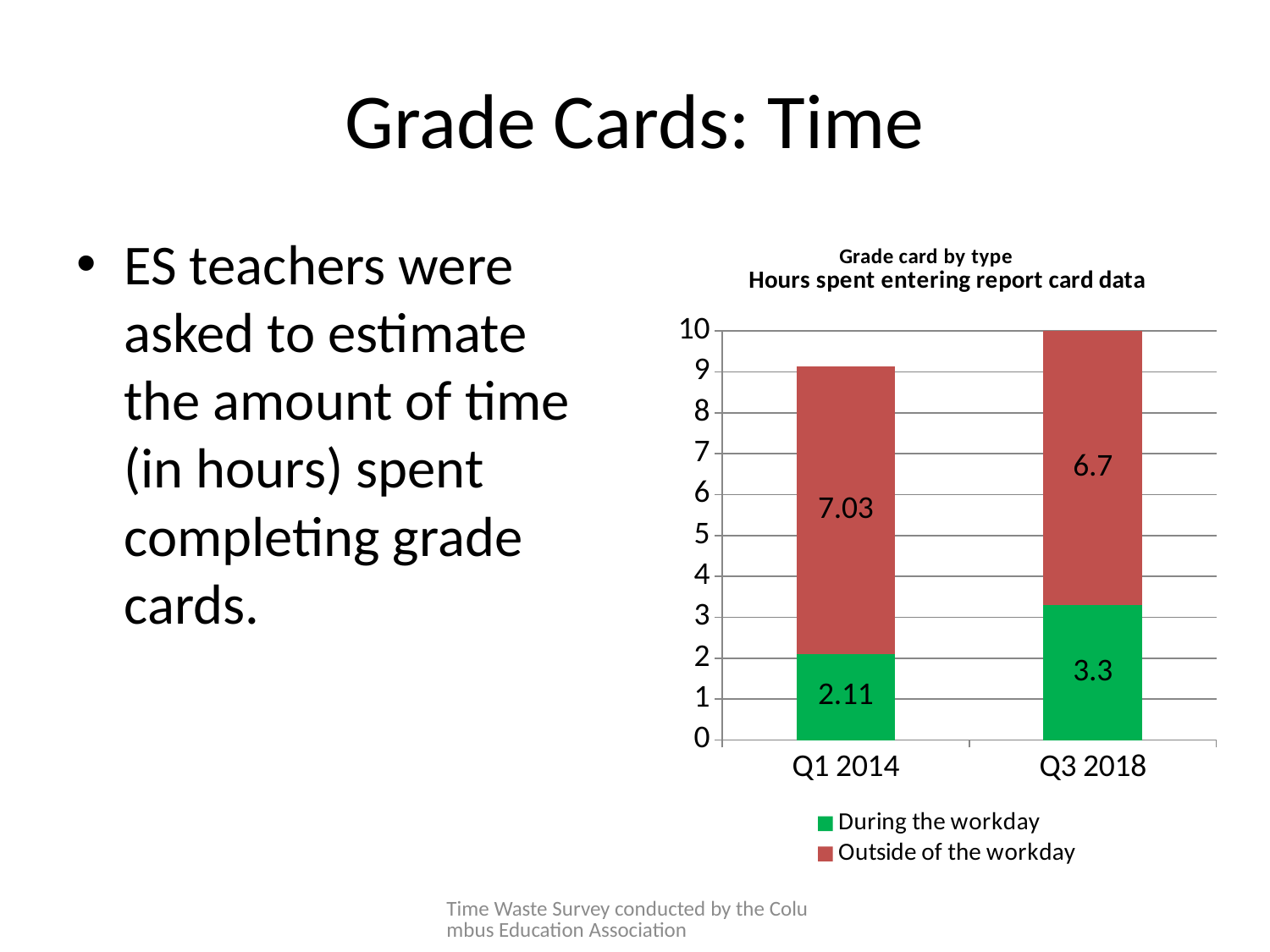
What is the value for "Outside of the workday" in Q1 2014? 7.03 What is the difference between the "During the workday" values for Q3 2018 and Q1 2014? 1.19 What is the total of the stacked bar for Q3 2018? 10 What is the value for "During the workday" in Q1 2014? 2.11 How many series does the legend list? 2 What kind of chart is shown on the slide? Stacked bar chart What is the total of the stacked bar for Q1 2014? 9.14 How many categories are shown on the x axis? 2 Which is larger: "Outside of the workday" in Q1 2014 or in Q3 2018? Q1 2014 What is the value for "During the workday" in Q3 2018? 3.3 What is the value for "Outside of the workday" in Q3 2018? 6.7 Which colour represents "During the workday" in the chart? Green